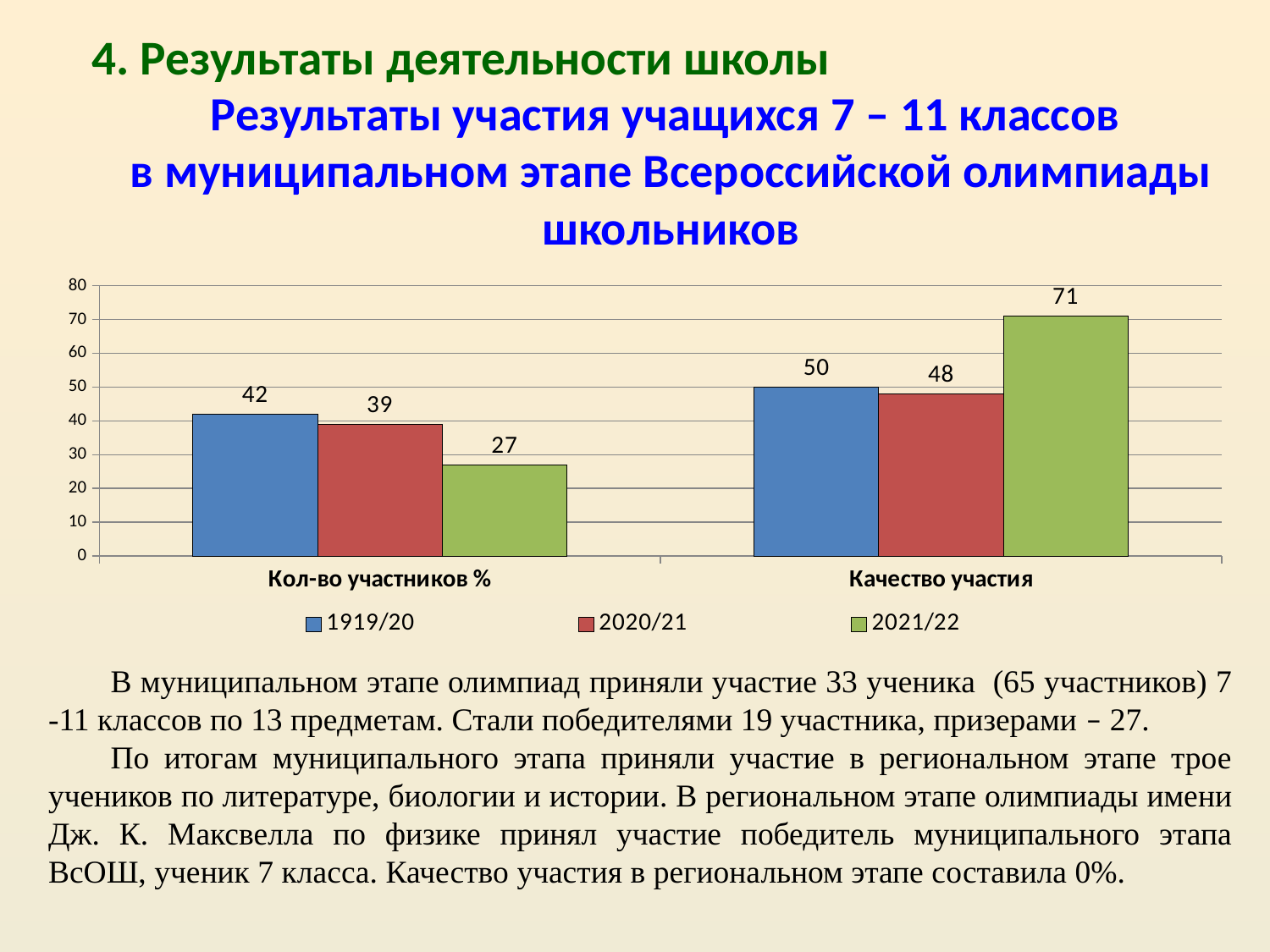
How many series does the legend list? 3 What is the value for 2021/22 in the "Качество участия" category? 71 Which is larger: the 2020/21 value for "Кол-во участников %" or the 2020/21 value for "Качество участия"? Качество участия What is the value for 1919/20 in the "Кол-во участников %" category? 42 How many categories are shown on the x axis? 2 Which series has the lowest value in the "Кол-во участников %" category? 2021/22 Which series has the highest value in the "Качество участия" category? 2021/22 What is the difference between the 1919/20 value and the 2020/21 value in the "Кол-во участников %" category? 3 What is the value for 2020/21 in the "Качество участия" category? 48 What kind of chart is shown on the slide? Bar chart Which colour represents the 2020/21 series in the chart? Red What is the difference between the 2021/22 value and the 1919/20 value in the "Качество участия" category? 21